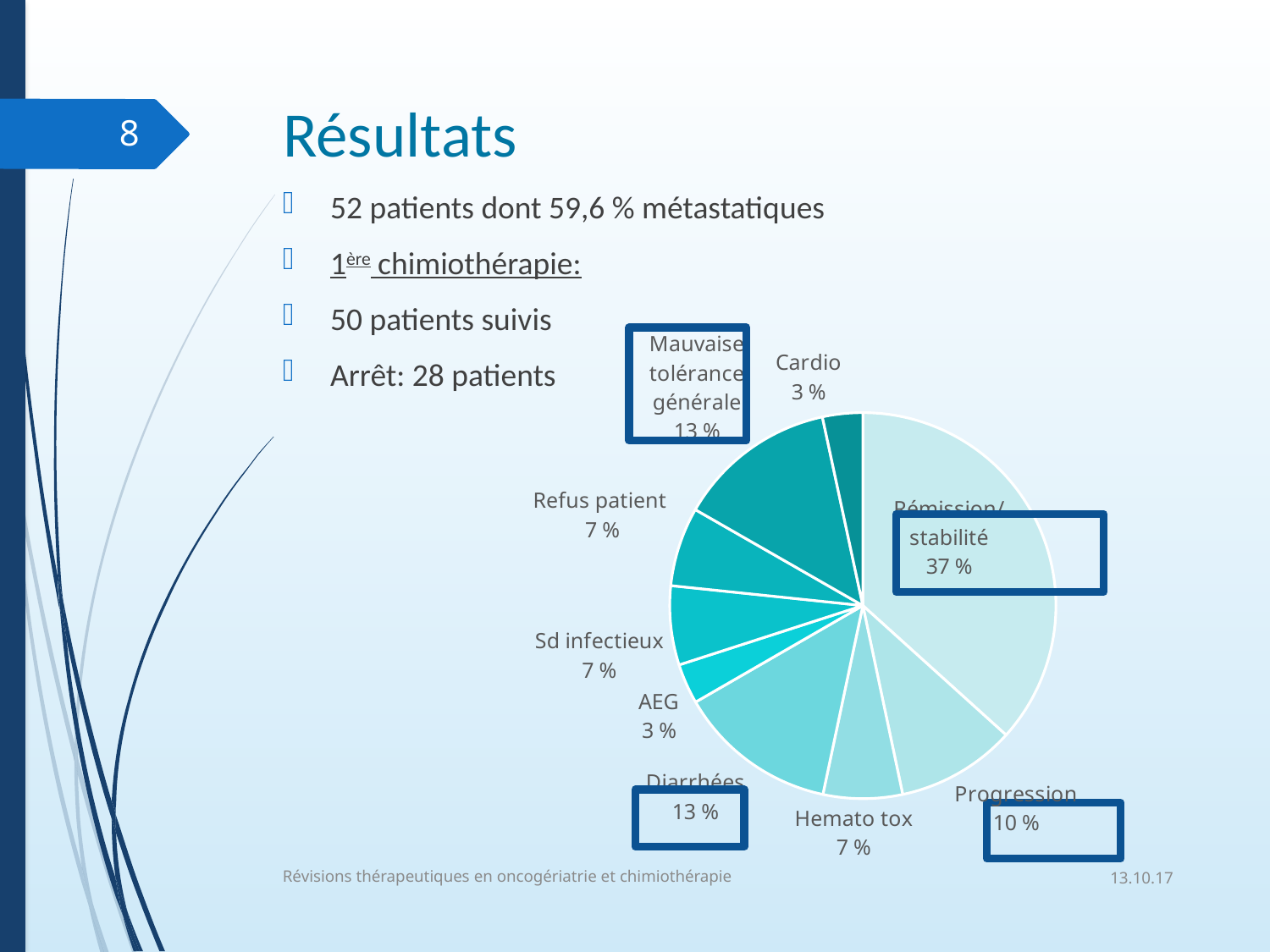
How many categories are shown in the pie chart? 9 What is the value shown for Mauvaise tolérance générale? 13 % What share of the pie does Rémission/stabilité represent? 37 % What is the value shown for Progression? 10 % What is the value shown for AEG? 3 % What is the value shown for Hemato tox? 7 % What is the value shown for Cardio? 3 % What is the difference between Rémission/stabilité and Progression? 27 % Which is larger, Progression or Refus patient? Progression What is the value shown for Diarrhées? 13 % What kind of chart is shown on the slide? pie chart Which category has the largest slice of the pie? Rémission/stabilité